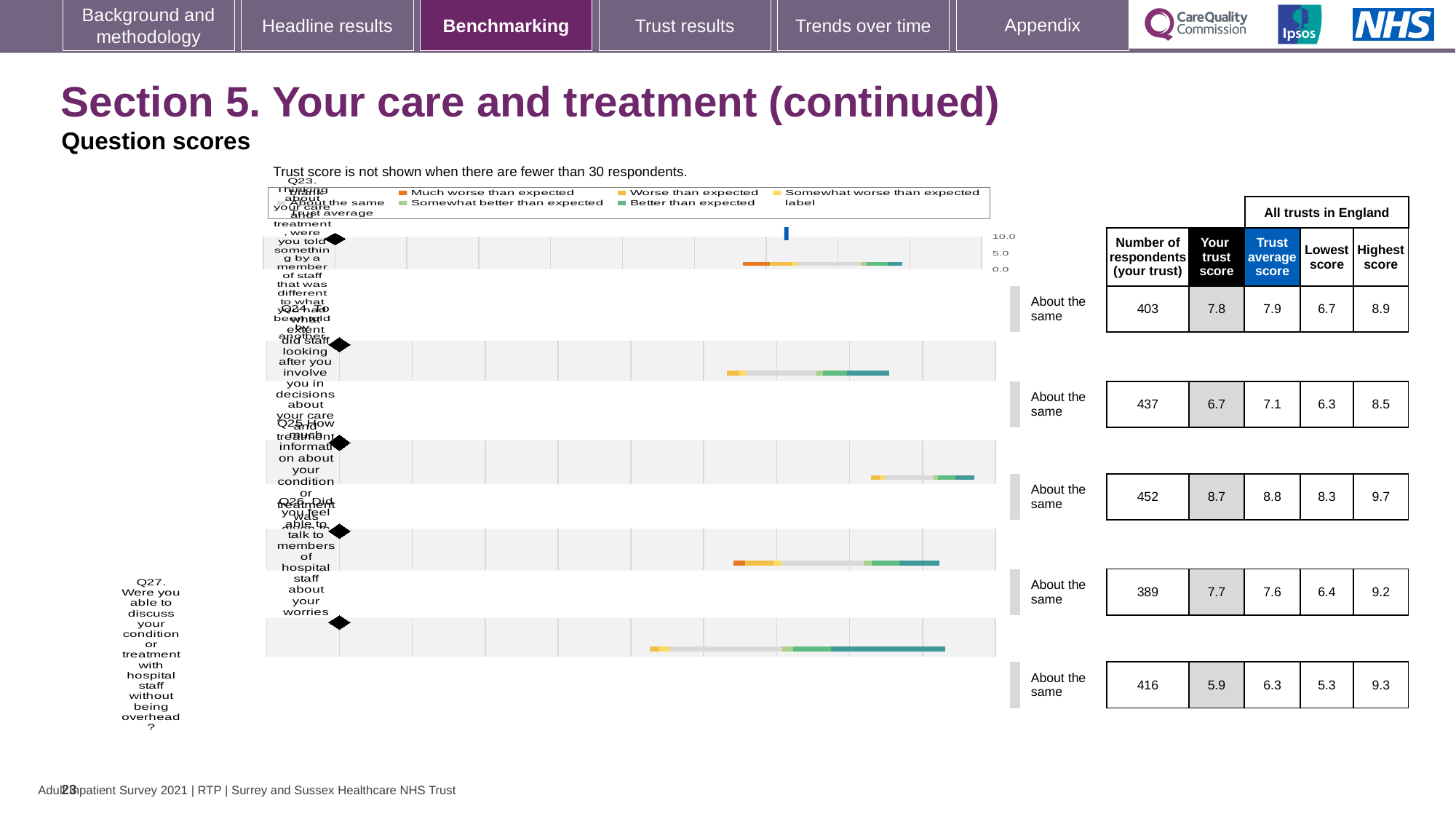
What is the 'Your trust score' for Q27 (discussing your condition or treatment without being overheard)? 5.9 What benchmark category is shown for every question on this slide? About the same What is the difference between the trust average score and 'Your trust score' for Q27? 0.4 Which question has the lowest 'Your trust score' on this slide? Q27 How many questions are benchmarked on this slide? 5 For Q23, which is larger: 'Your trust score' or the trust average score? Trust average score What is the trust average score for Q24 (staff involving you in decisions about your care and treatment)? 7.1 Which question has the highest 'Your trust score' on this slide? Q25 What kind of chart is used to show the question scores on this slide? Bar chart How many respondents answered Q25 (how much information about your condition or treatment was given)? 452 For Q26, which is larger: 'Your trust score' or the trust average score? Your trust score What is the highest score across all trusts in England for Q26 (able to talk to hospital staff about your worries)? 9.2